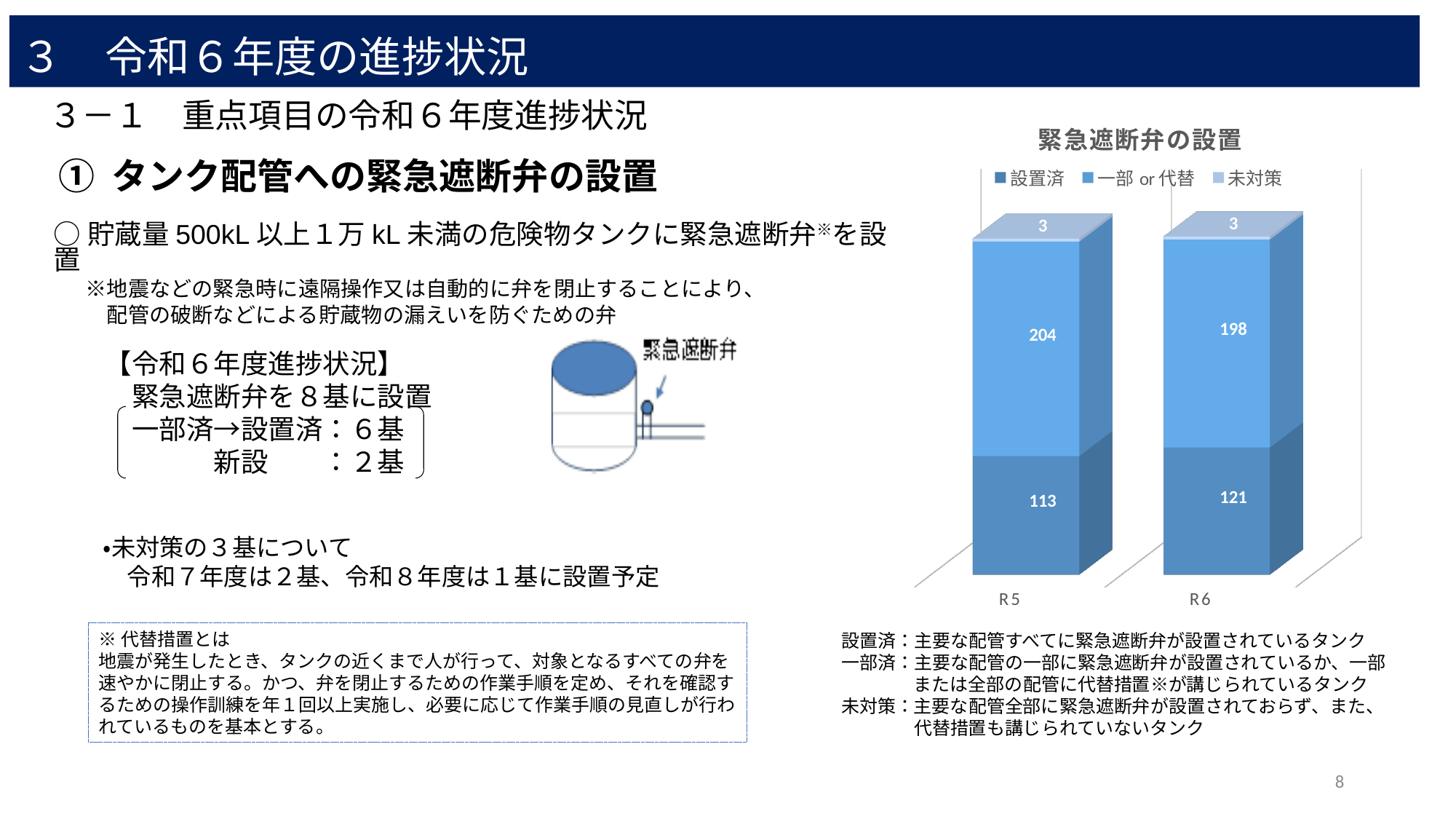
What is the value for 一部 or 代替 in R6? 198 What is the difference between the 一部 or 代替 values for R5 and R6? 6 How many series does the legend list? 3 What is the difference between the 設置済 values for R6 and R5? 8 What is the total of the stacked bar for R5? 320 Which year has the larger 一部 or 代替 value, R5 or R6? R5 Which year has the larger 設置済 value, R5 or R6? R6 What is the value for 設置済 in R5? 113 What is the total of the stacked bar for R6? 320 What kind of chart is shown on the slide? Stacked bar chart What is the value for 設置済 in R6? 121 What is the value for 未対策 in R5? 3